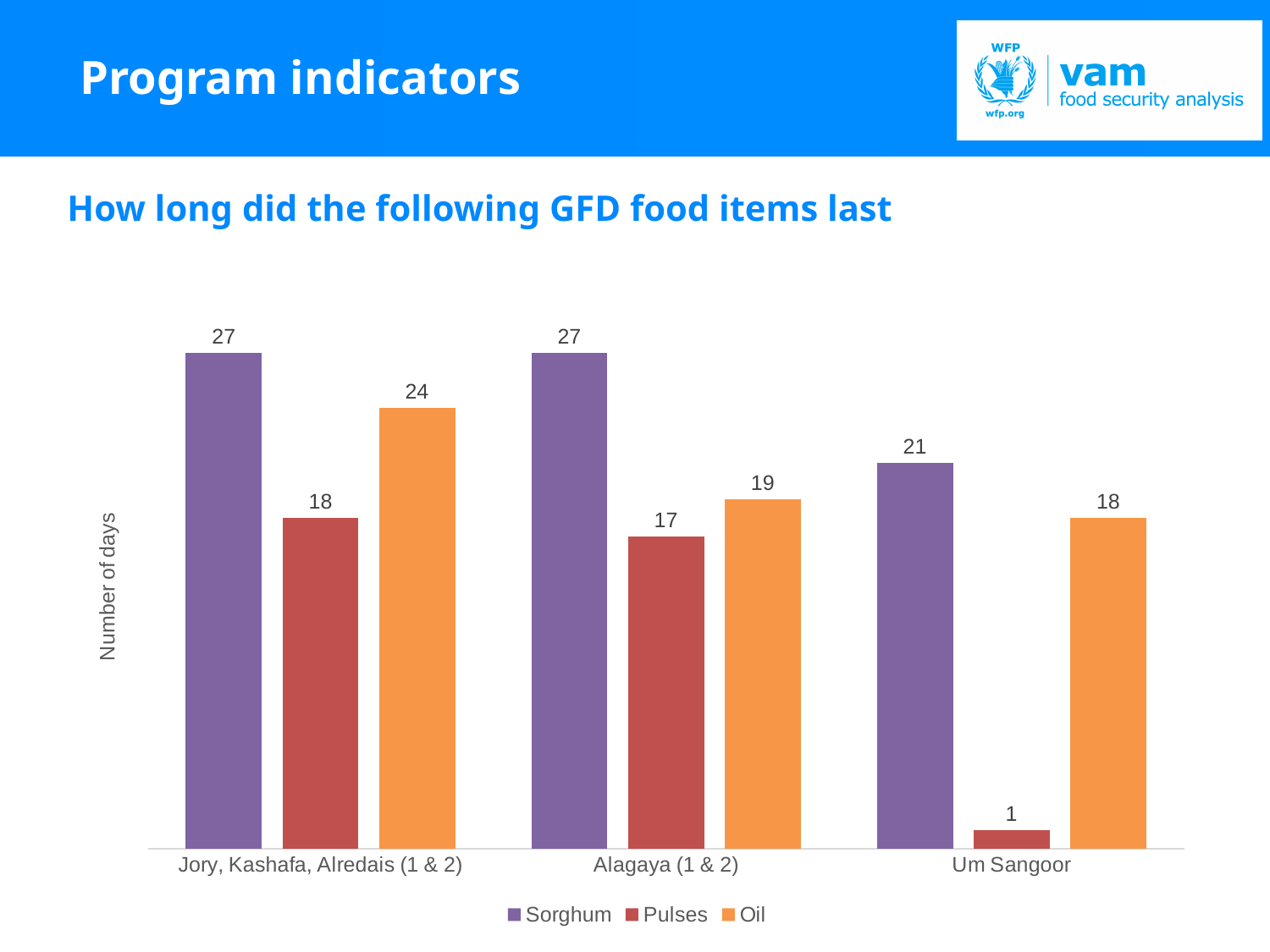
How many series does the legend list? 3 How many days did Pulses last in Um Sangoor? 1 Which location has the highest value for Oil? Jory, Kashafa, Alredais (1 & 2) Which location has the lowest value for Pulses? Um Sangoor What kind of chart is shown on the slide? Bar chart What is the difference between Sorghum in Alagaya (1 & 2) and Sorghum in Um Sangoor? 6 What is the label of the vertical axis? Number of days How many days did Oil last in Alagaya (1 & 2)? 19 What is the difference in days between Oil and Pulses in Um Sangoor? 17 Which lasted longer in Alagaya (1 & 2), Pulses or Oil? Oil How many days did Sorghum last in Jory, Kashafa, Alredais (1 & 2)? 27 How many locations are shown on the x axis? 3